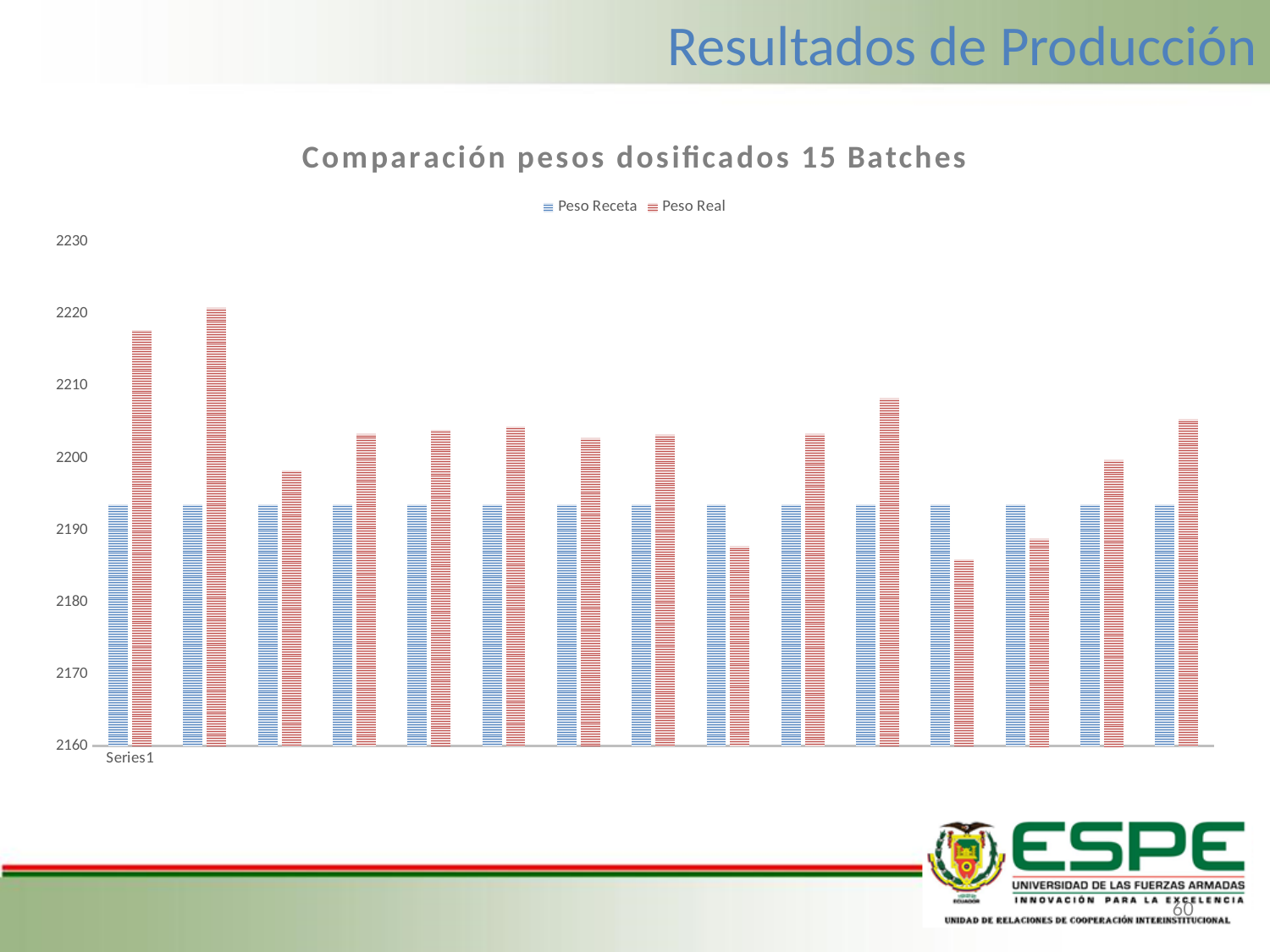
For the first batch on the left, which is larger: Peso Receta or Peso Real? Peso Real How many series does the legend list? 2 Is the value of the Peso Receta bars greater or less than 2200? less Is the Peso Real value for the second batch from the left greater or less than 2210? greater Which batch has the highest Peso Real value? the second batch from the left What are the two series named in the legend? Peso Receta and Peso Real Is the value of the Peso Receta bars greater or less than 2190? greater What kind of chart is shown on the slide? bar chart Do the Peso Receta values change across the batches along the x axis? No, they stay constant How many pairs of bars (batches) are plotted in the chart? 15 What is the title of the chart? Comparación pesos dosificados 15 Batches